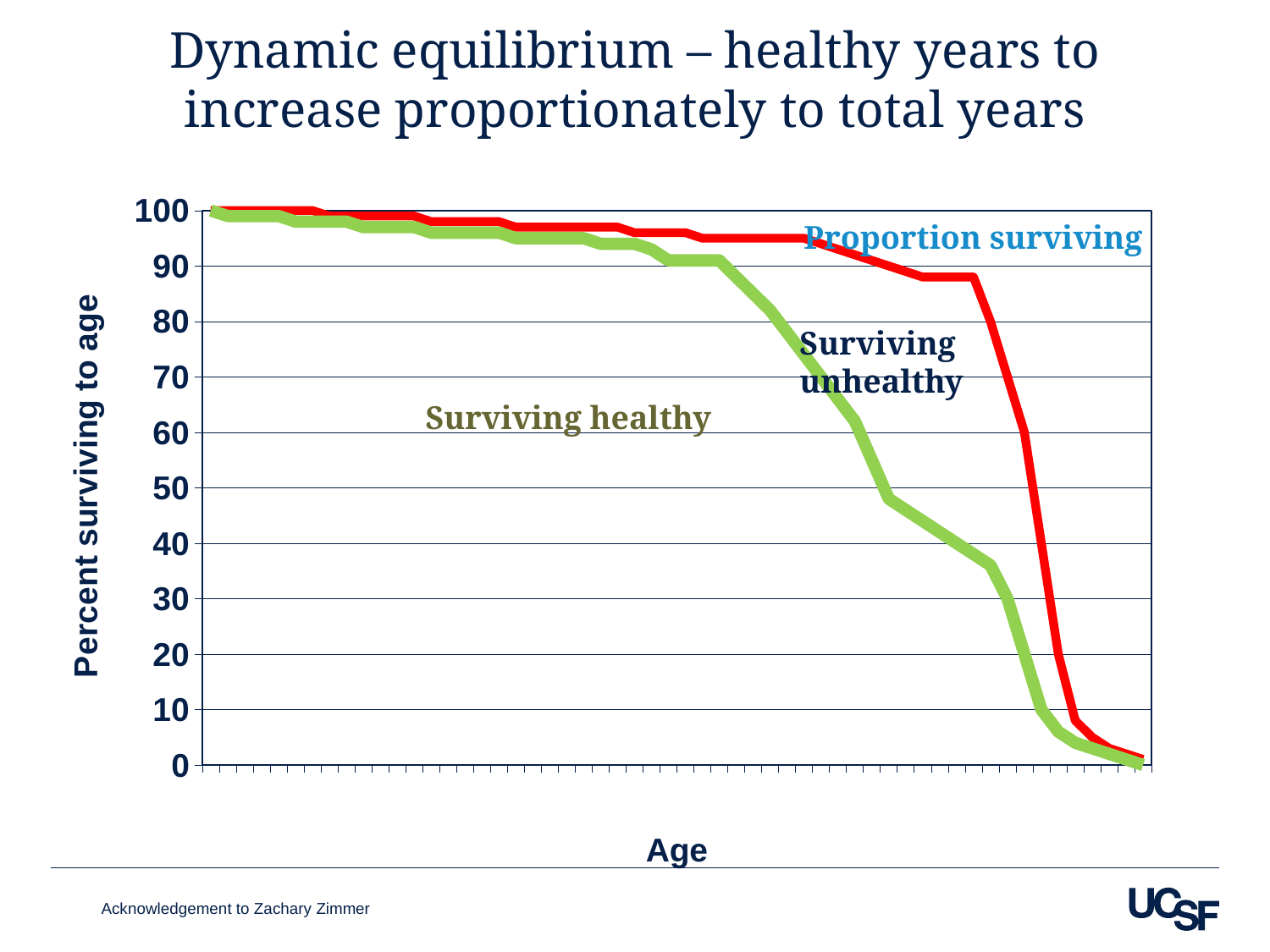
Do the plotted values rise or fall as age increases along the x axis? fall Which line lies higher on the chart, the red 'Proportion surviving' line or the green 'Surviving healthy' line? Proportion surviving How many lines are plotted on the chart? 2 What kind of chart is shown on the slide? line chart Which line drops toward zero at a younger age, 'Proportion surviving' or 'Surviving healthy'? Surviving healthy What is the title of the vertical axis? Percent surviving to age What label is given to the gap between the red and green lines? Surviving unhealthy